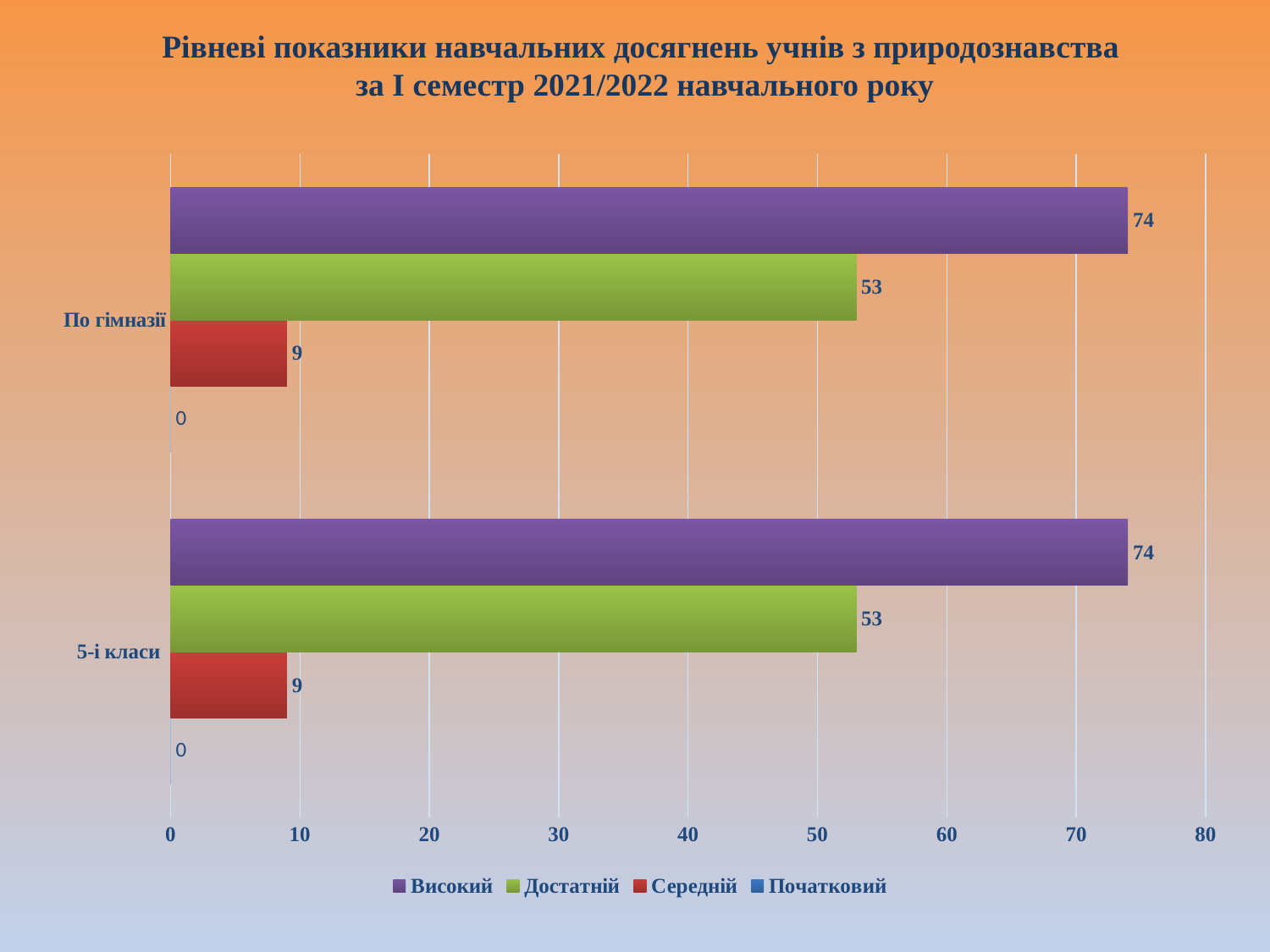
What kind of chart is shown on the slide? Bar chart What is the difference between the Високий and Достатній values for По гімназії? 21 What is the value for Достатній for 5-і класи? 53 Which is larger for 5-і класи: Достатній or Середній? Достатній Which series has the highest value for 5-і класи? Високий What is the value for Високий for По гімназії? 74 What is the value for Середній for По гімназії? 9 What colour are the Достатній bars? Green What is the value for Початковий for 5-і класи? 0 How many categories are shown on the chart? 2 How many series does the legend list? 4 Which series has the lowest value for По гімназії? Початковий